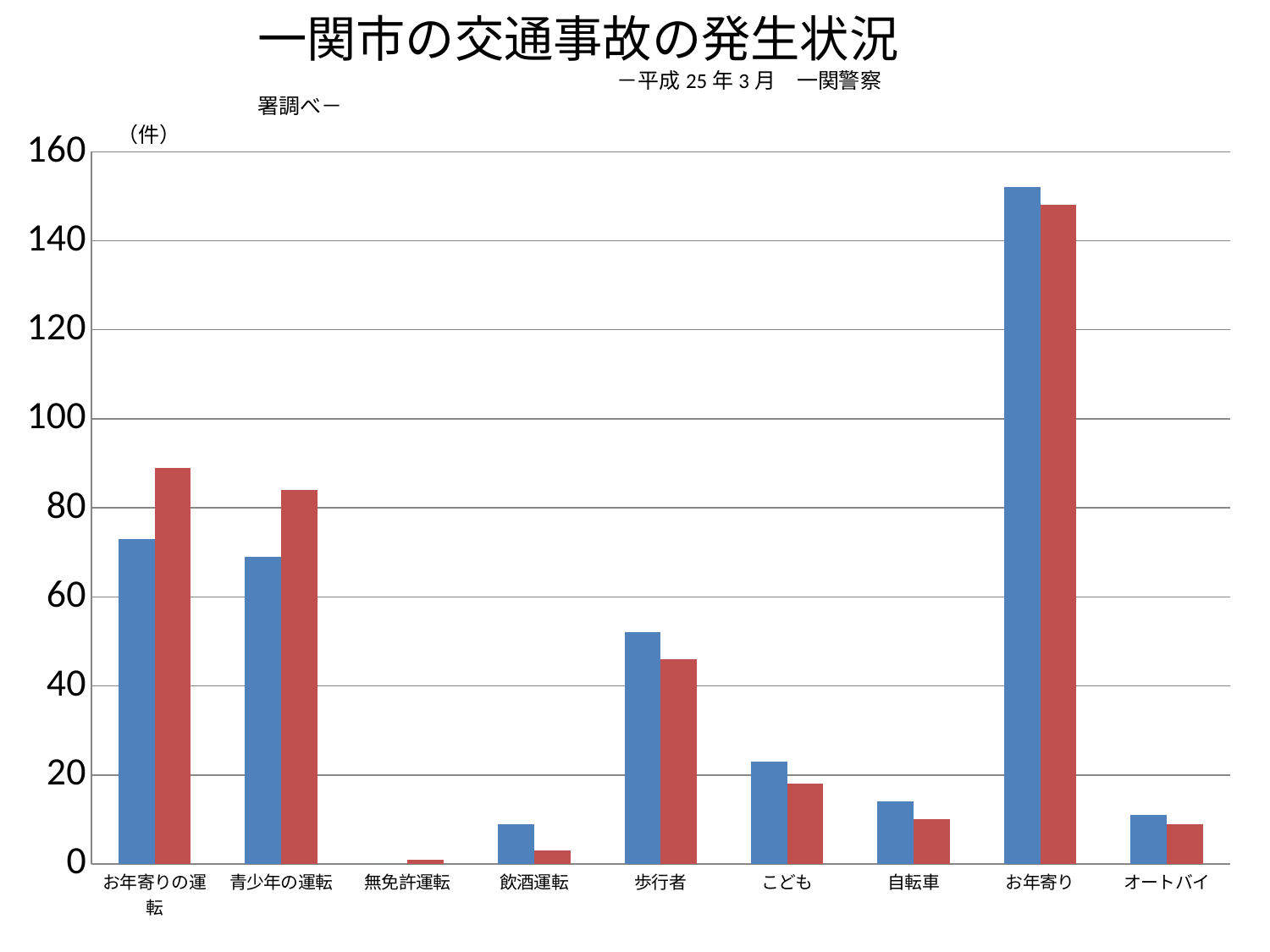
For お年寄りの運転, which bar is taller, the blue one or the red one? the red one Which category has the highest blue bar? お年寄り Which category has the lowest red bar? 無免許運転 Is the blue bar for 歩行者 greater or less than 60? less What unit is shown at the top of the y axis? （件） For 歩行者, which bar is taller, the blue one or the red one? the blue one What kind of chart is shown on the slide? bar chart How many categories are shown along the x axis of the chart? 9 Is the red bar for お年寄りの運転 greater or less than 80? greater Is the blue bar for お年寄り greater or less than 140? greater What is the title of the chart? 一関市の交通事故の発生状況